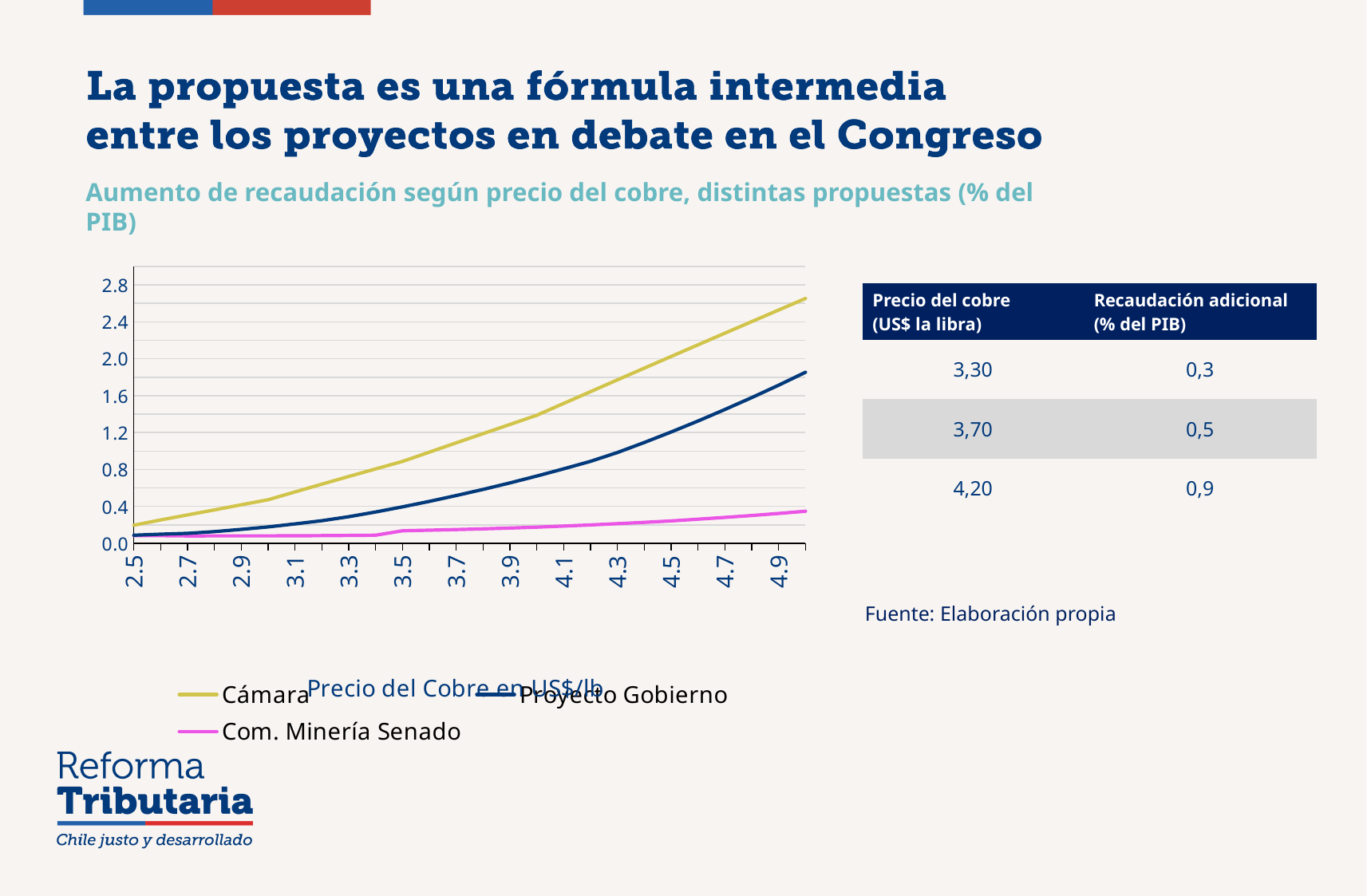
What is the title of the chart's x axis? Precio del Cobre en US$/lb How many series does the chart's legend list? 3 Is the value of the Cámara line at a copper price of 2.5 greater or less than 0.4? less Is the value of the Com. Minería Senado line at a copper price of 4.9 greater or less than 0.4? less At a copper price of 4.9, which is larger: the Cámara line or the Proyecto Gobierno line? Cámara Which series has the highest values across the copper price range in the chart? Cámara What kind of chart is shown on the slide? Line chart Is the value of the Cámara line at a copper price of 4.9 greater or less than 2.4? greater How many copper price labels are shown on the chart's x axis? 13 Does the Proyecto Gobierno line rise or fall as the copper price increases? Rises Which series has the lowest values across the copper price range in the chart? Com. Minería Senado